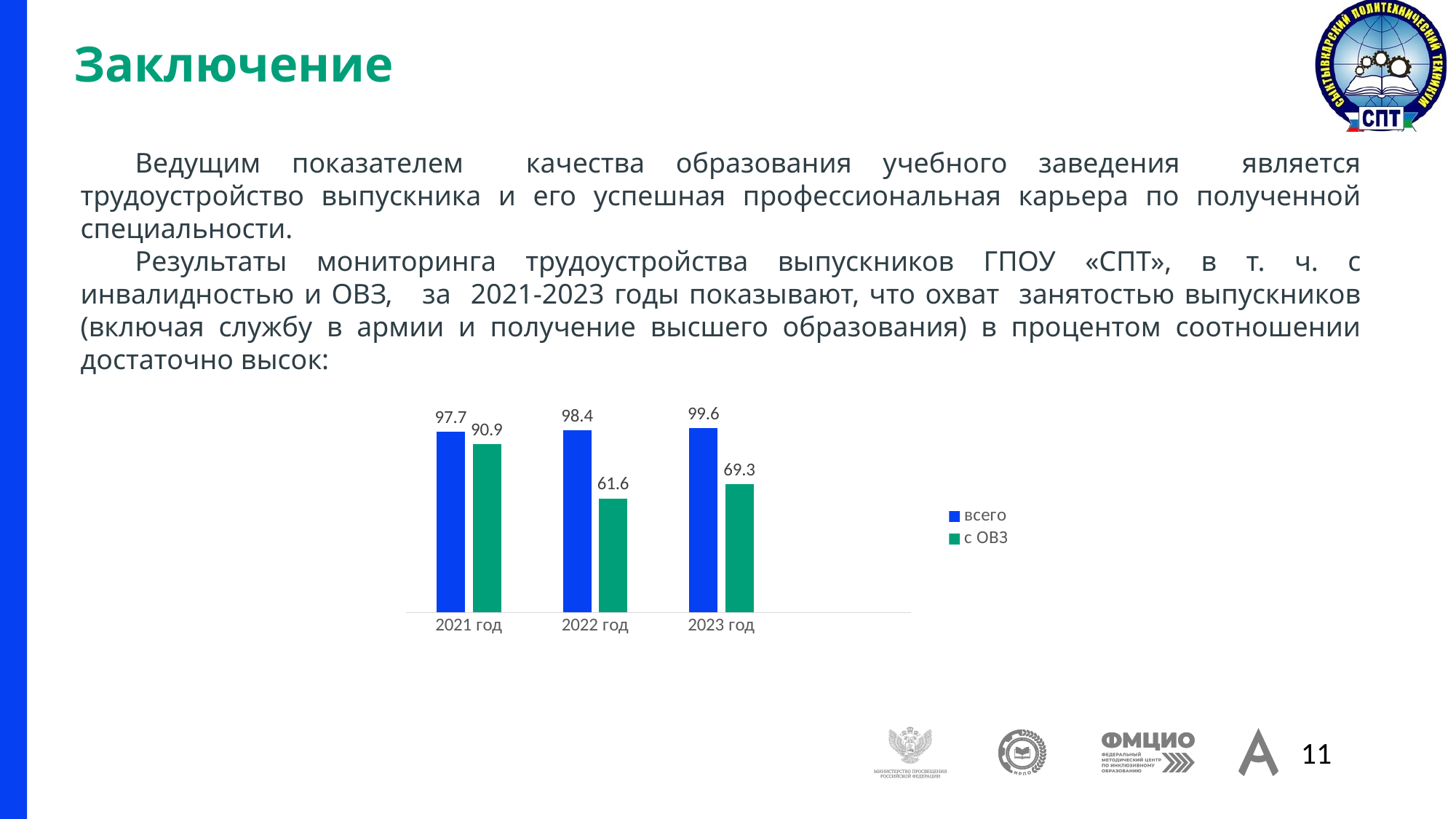
In which year is the "с ОВЗ" value highest? 2021 год Do the "всего" values rise or fall from 2021 год to 2023 год? rise Which is larger in 2021 год: "всего" or "с ОВЗ"? всего What kind of chart is shown on the slide? bar chart What is the value for "всего" in 2023 год? 99.6 What is the value for "всего" in 2021 год? 97.7 What is the value for "с ОВЗ" in 2023 год? 69.3 In which year is the "с ОВЗ" value lowest? 2022 год How many years are shown on the x axis? 3 What is the difference between the "всего" and "с ОВЗ" values in 2022 год? 36.8 What is the value for "с ОВЗ" in 2022 год? 61.6 How many series does the legend list? 2